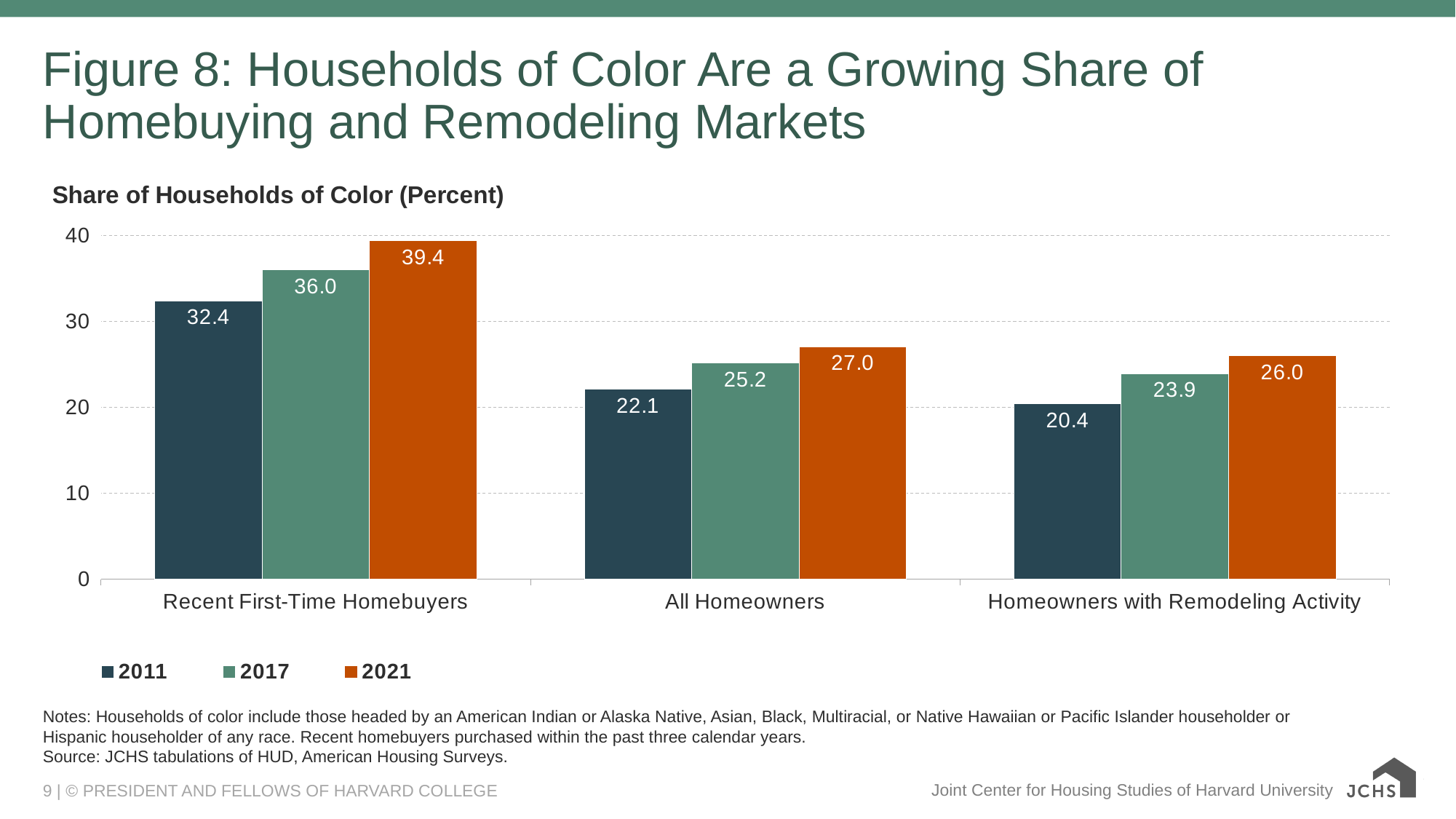
How many categories are shown on the x axis? 3 What kind of chart is shown on the slide? Bar chart What is the 2021 value for Recent First-Time Homebuyers? 39.4 What is the difference between the 2021 and 2011 values for Recent First-Time Homebuyers? 7.0 Which is larger: the 2017 value for All Homeowners or the 2017 value for Homeowners with Remodeling Activity? All Homeowners What is the difference between the 2021 values for All Homeowners and Homeowners with Remodeling Activity? 1.0 Which category has the highest 2021 value? Recent First-Time Homebuyers Which category has the lowest 2011 value? Homeowners with Remodeling Activity What is the 2011 value for All Homeowners? 22.1 How many series does the legend list? 3 Do the values for All Homeowners rise or fall from 2011 to 2021? Rise What is the 2017 value for Homeowners with Remodeling Activity? 23.9